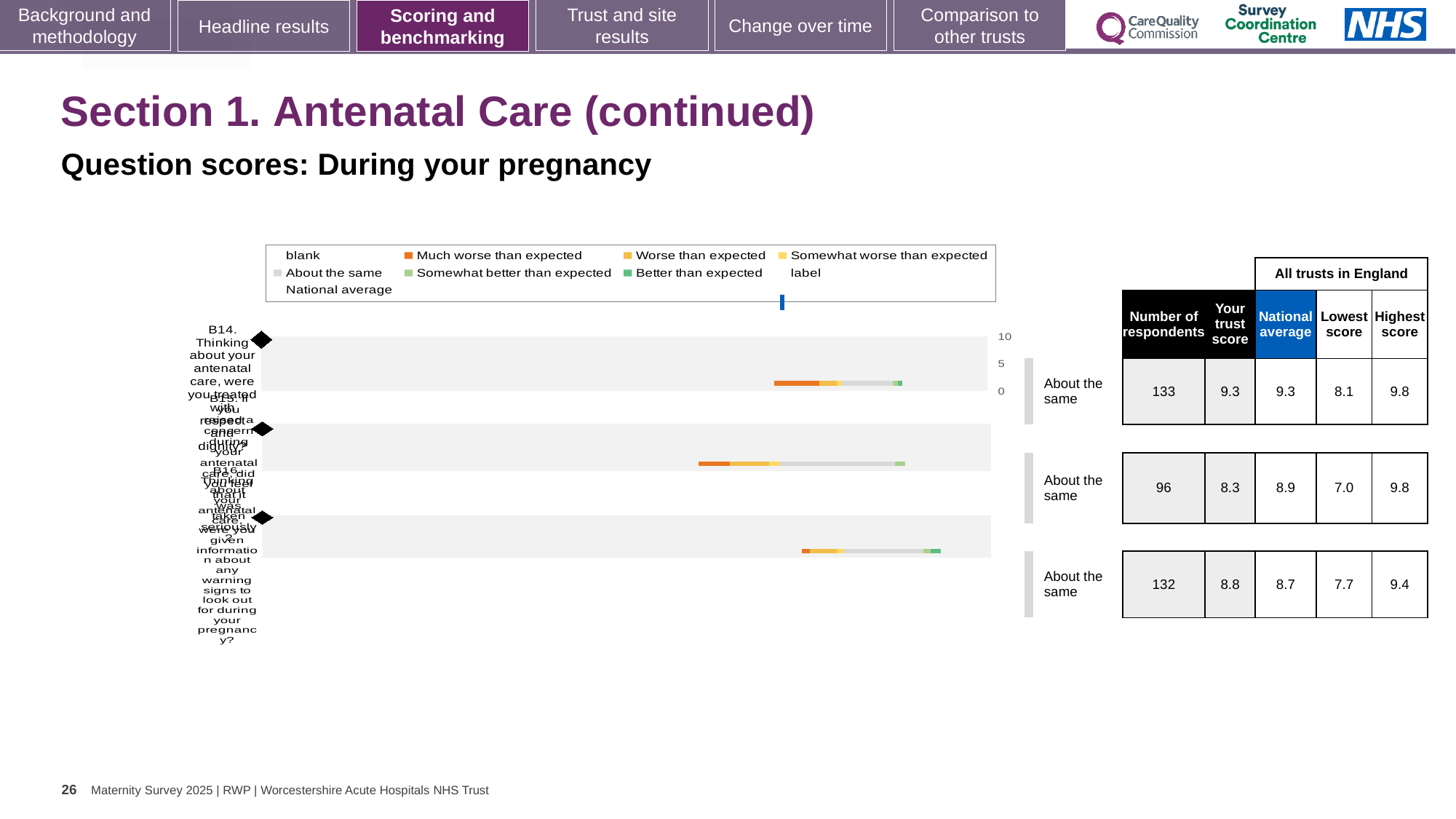
In the table beside the chart, which row has the fewest respondents? the second row (96) What benchmark category is shown next to each of the three bars? About the same How many question bars are plotted in the chart? 3 What kind of chart is shown on the slide? bar chart Which colour does the legend use for 'Much worse than expected'? orange In the table beside the chart, what is the highest score for the third row? 9.4 In the table beside the chart, what is 'Your trust score' for the first row (B14)? 9.3 In the table beside the chart, what is the difference between 'Your trust score' and the 'National average' for the third row? 0.1 In the table beside the chart, what is the number of respondents for the first row (B14)? 133 In the table beside the chart, for the second row, which is larger: 'Your trust score' or the 'National average'? National average What is the highest tick value shown on the chart's score axis? 10 In the table beside the chart, what is the lowest score for the second row? 7.0